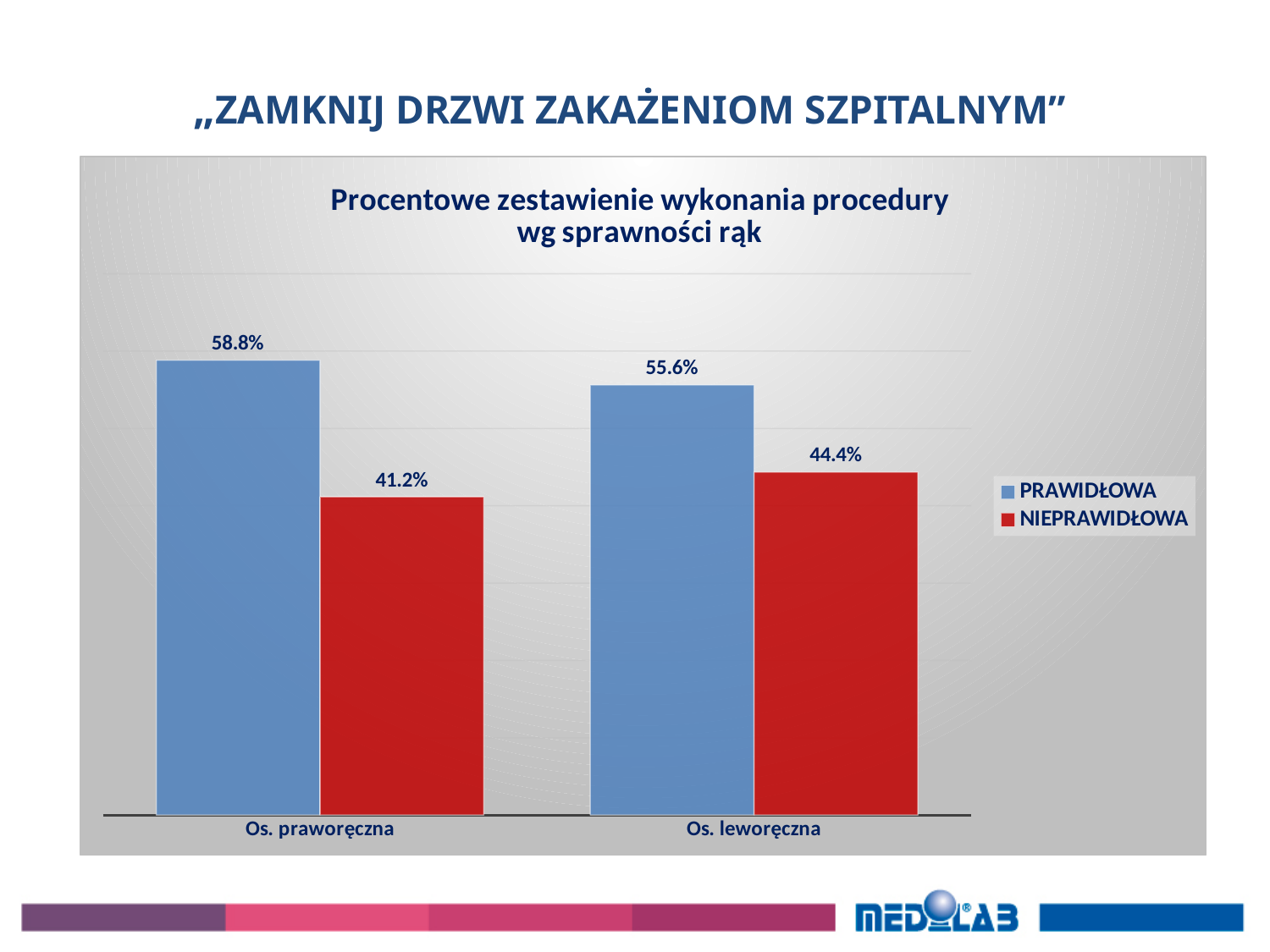
What is the NIEPRAWIDŁOWA value for Os. praworęczna? 41.2% What kind of chart is shown on the slide? Bar chart What is the PRAWIDŁOWA value for Os. praworęczna? 58.8% How many series does the legend list? 2 What is the PRAWIDŁOWA value for Os. leworęczna? 55.6% What is the difference between the PRAWIDŁOWA and NIEPRAWIDŁOWA values for Os. praworęczna? 17.6% What is the NIEPRAWIDŁOWA value for Os. leworęczna? 44.4% Which category has the highest PRAWIDŁOWA value? Os. praworęczna What is the difference between the PRAWIDŁOWA values for Os. praworęczna and Os. leworęczna? 3.2% Which is larger for Os. leworęczna: PRAWIDŁOWA or NIEPRAWIDŁOWA? PRAWIDŁOWA How many categories are shown on the x axis? 2 Which category has the lowest NIEPRAWIDŁOWA value? Os. praworęczna